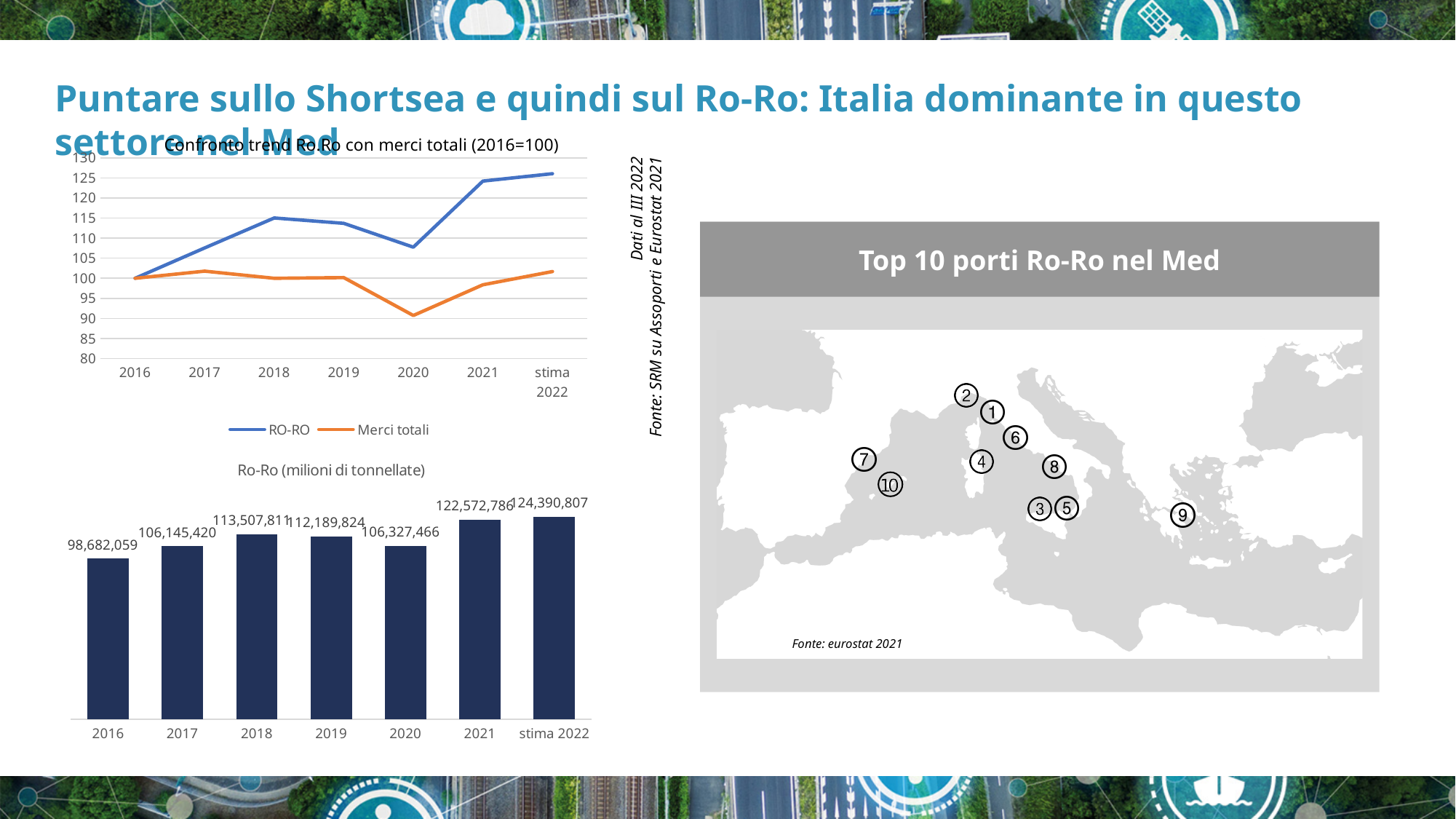
In the line chart 'Confronto trend Ro.Ro con merci totali (2016=100)', is the Merci totali value for 2020 greater or less than 95? less In the bar chart 'Ro-Ro (milioni di tonnellate)', what is the value for 2016? 98,682,059 In the line chart 'Confronto trend Ro.Ro con merci totali (2016=100)', is the RO-RO value for 2021 greater or less than 120? greater What type of chart is 'Confronto trend Ro.Ro con merci totali (2016=100)'? line chart In the bar chart 'Ro-Ro (milioni di tonnellate)', which year has the lowest value? 2016 In the bar chart 'Ro-Ro (milioni di tonnellate)', which category has the highest value? stima 2022 In the bar chart 'Ro-Ro (milioni di tonnellate)', which is larger, the value for 2018 or the value for 2019? 2018 In the bar chart 'Ro-Ro (milioni di tonnellate)', what is the value for 2021? 122,572,786 How many bars are shown in the bar chart 'Ro-Ro (milioni di tonnellate)'? 7 How many series does the legend of the line chart 'Confronto trend Ro.Ro con merci totali (2016=100)' list? 2 In the bar chart 'Ro-Ro (milioni di tonnellate)', what is the value for stima 2022? 124,390,807 In the bar chart 'Ro-Ro (milioni di tonnellate)', what is the difference between the 2021 value and the 2020 value? 16,245,320